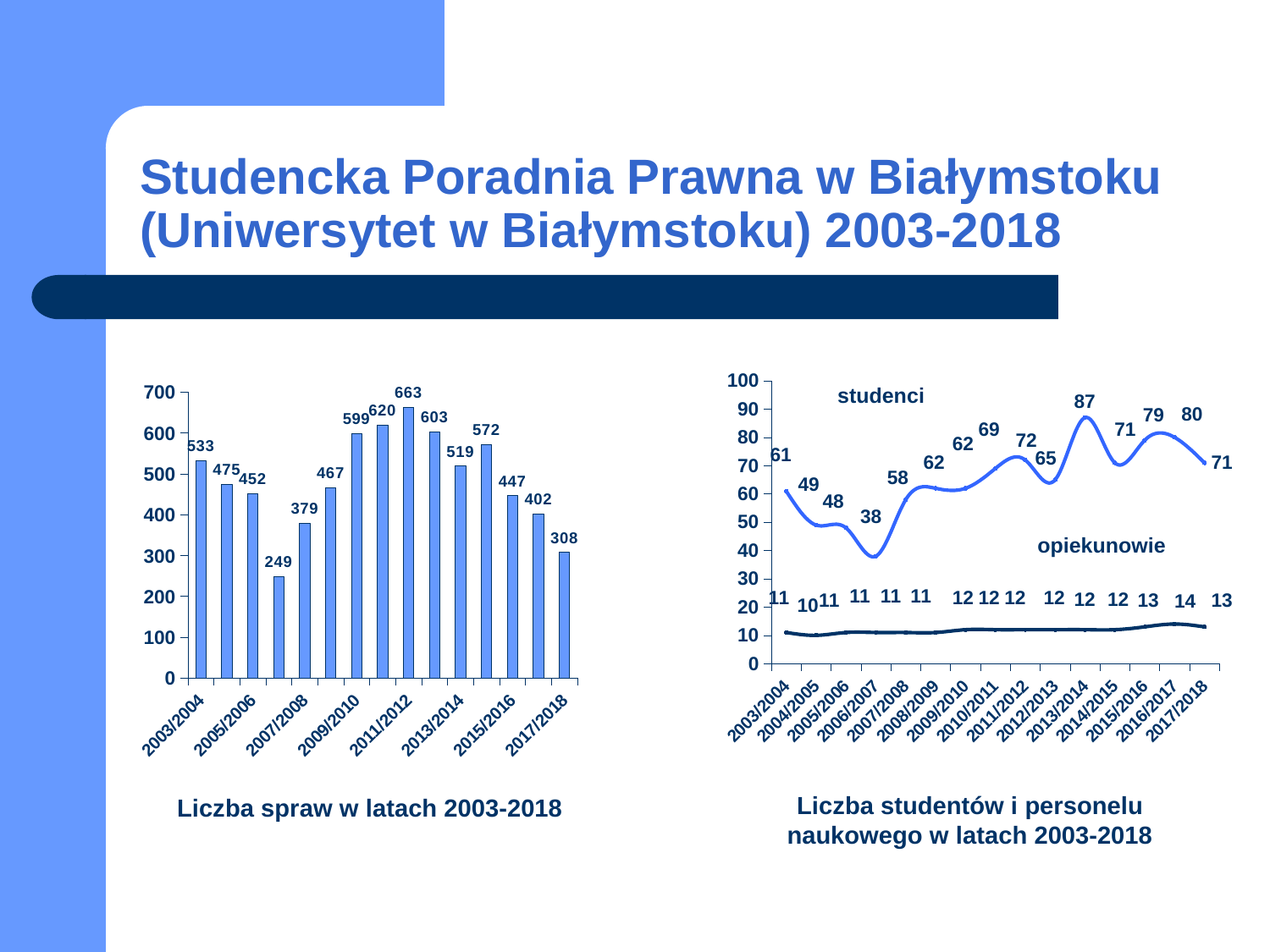
In the chart 'Liczba spraw w latach 2003-2018', how many bars are plotted? 15 How many series are plotted in the chart 'Liczba studentów i personelu naukowego w latach 2003-2018'? 2 In the chart 'Liczba spraw w latach 2003-2018', which year has the lowest value? 2006/2007 What type of chart is 'Liczba spraw w latach 2003-2018'? bar chart In the chart 'Liczba spraw w latach 2003-2018', what is the difference between the values for 2003/2004 and 2017/2018? 225 In the chart 'Liczba studentów i personelu naukowego w latach 2003-2018', which series is larger in 2003/2004, studenci or opiekunowie? studenci In the chart 'Liczba spraw w latach 2003-2018', what is the value for 2011/2012? 663 In the chart 'Liczba studentów i personelu naukowego w latach 2003-2018', what is the difference between studenci and opiekunowie in 2017/2018? 58 In the chart 'Liczba studentów i personelu naukowego w latach 2003-2018', what is the value of opiekunowie for 2016/2017? 14 In the chart 'Liczba spraw w latach 2003-2018', what is the value for 2007/2008? 379 In the chart 'Liczba studentów i personelu naukowego w latach 2003-2018', in which year is the studenci value lowest? 2006/2007 In the chart 'Liczba studentów i personelu naukowego w latach 2003-2018', what is the value of studenci for 2013/2014? 87